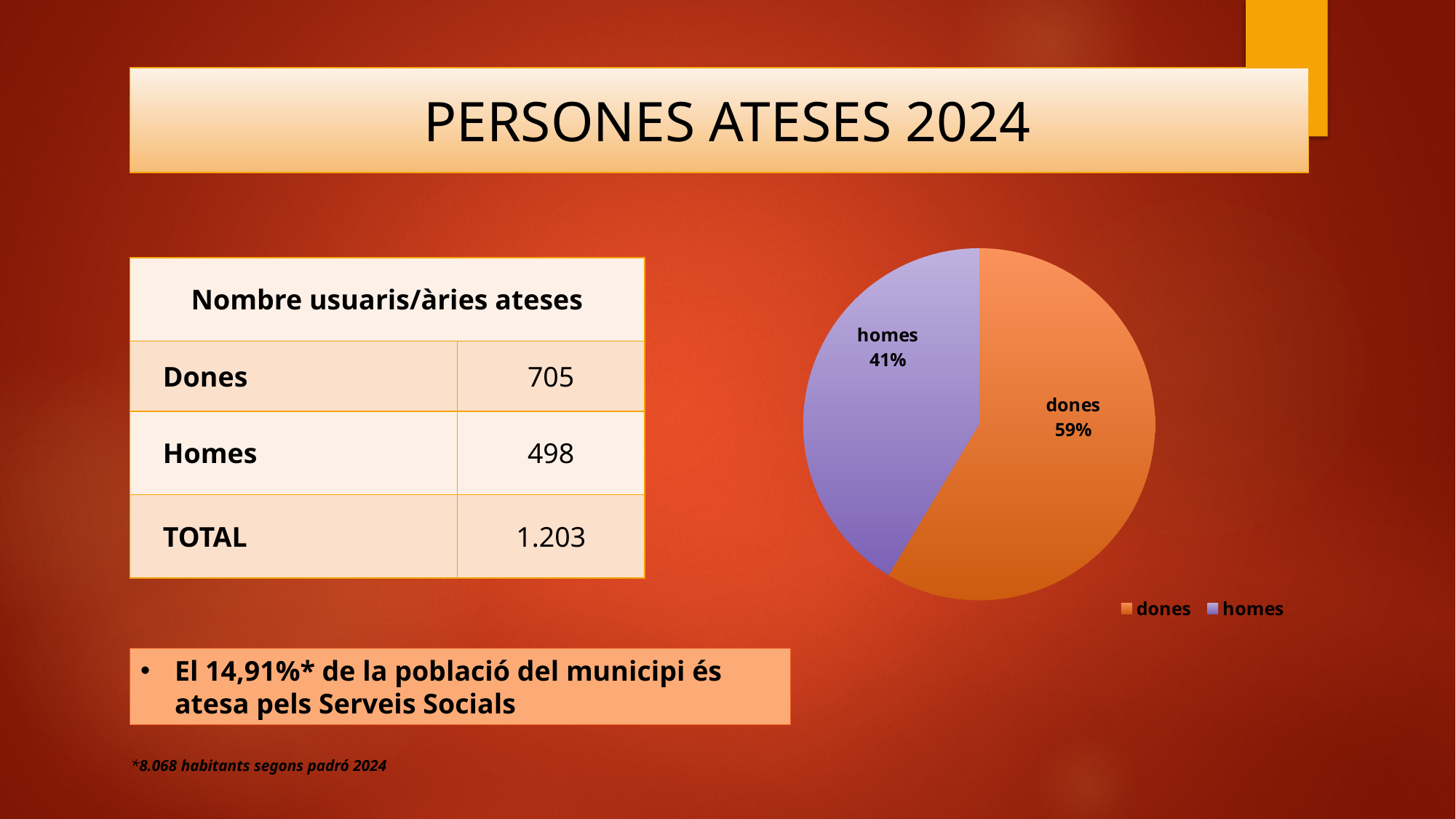
What is the difference in percentage points between the dones slice and the homes slice? 18% How many slices does the pie chart have? 2 How many entries does the legend of the pie chart list? 2 Which slice of the pie chart is the smallest? homes What kind of chart is shown on the slide? pie chart Which slice of the pie chart is the largest? dones What share of the pie does the "homes" slice represent? 41% Which is larger in the pie chart, the share for dones or the share for homes? dones What share of the pie does the "dones" slice represent? 59% What colour is the "dones" slice in the pie chart? orange What colour is the "homes" slice in the pie chart? purple